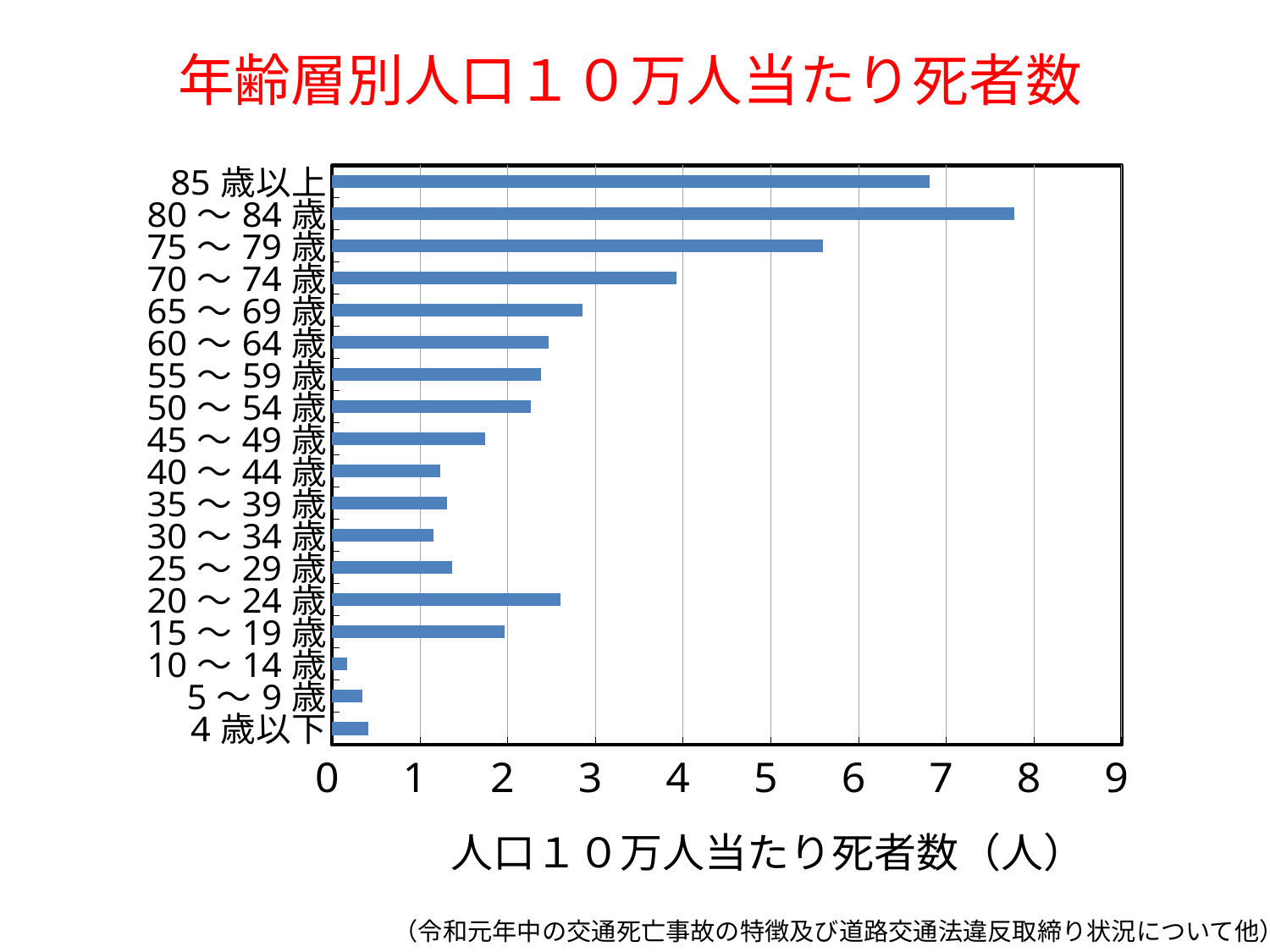
Is the value for 20～24歳 greater or less than 2? greater Which has a higher value, 20～24歳 or 25～29歳? 20～24歳 Is the value for 75～79歳 greater or less than 5? greater Which age group has the highest number of deaths per 100,000 population? 80～84歳 How many age groups are plotted in the chart? 18 Which has a higher value, 85歳以上 or 75～79歳? 85歳以上 What is the label of the horizontal axis? 人口１０万人当たり死者数（人） Is the value for 85歳以上 greater or less than 7? less Which age group has the lowest number of deaths per 100,000 population? 10～14歳 What kind of chart is shown on the slide? bar chart